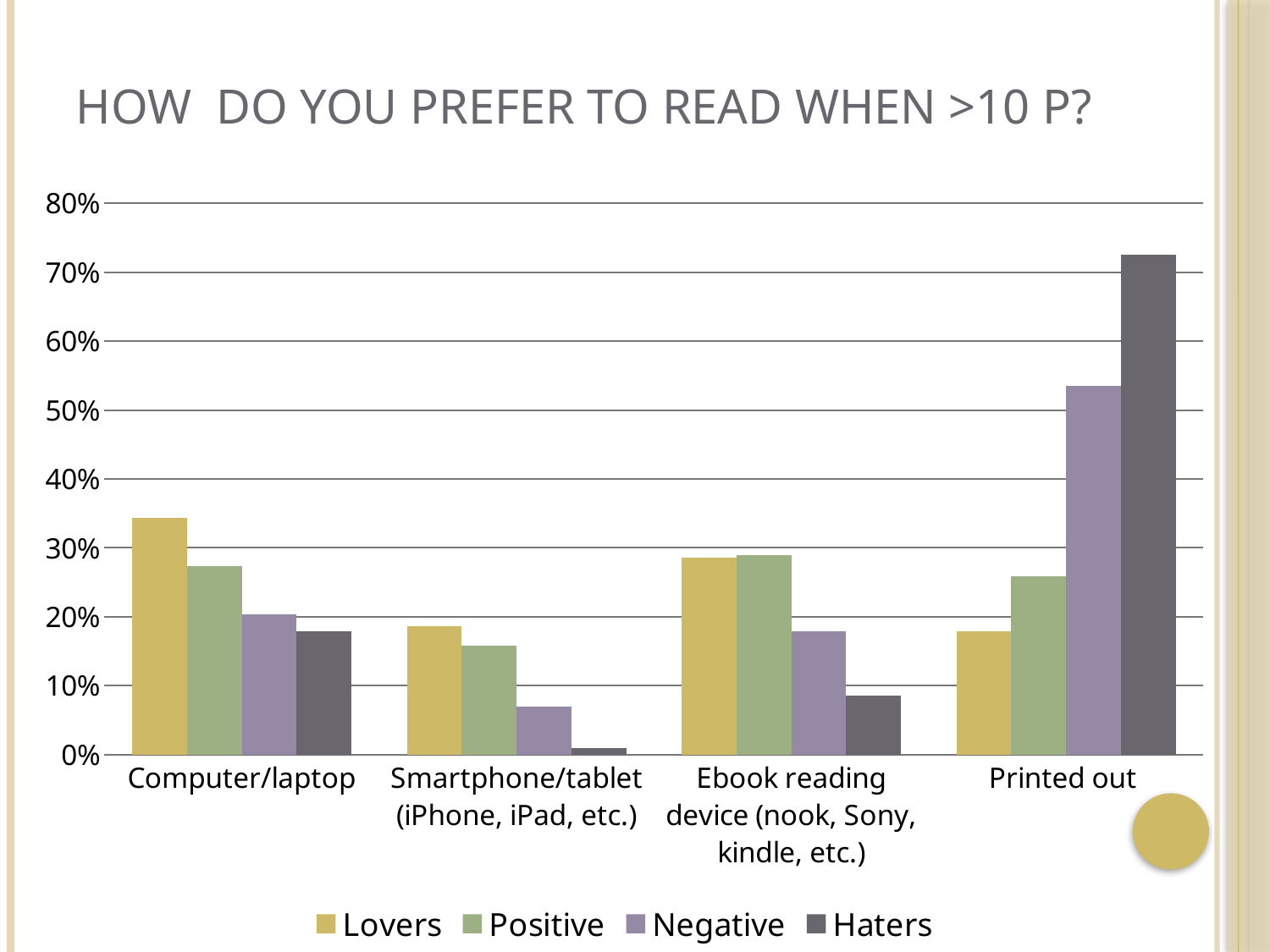
Is the Haters value for Printed out greater or less than 70%? greater For Printed out, which is larger: the Negative value or the Positive value? Negative Which category has the highest value for the Haters series? Printed out What is the title of the chart? HOW DO YOU PREFER TO READ WHEN >10 P? Which series has the highest value in the Computer/laptop category? Lovers Is the Negative value for Printed out greater or less than 50%? greater How many series does the legend list? 4 What kind of chart is shown on the slide? bar chart Is the Lovers value for Computer/laptop greater or less than 30%? greater For Computer/laptop, which is larger: the Lovers value or the Haters value? Lovers Which category has the lowest value for the Haters series? Smartphone/tablet (iPhone, iPad, etc.) How many reading-method categories are shown on the x axis? 4